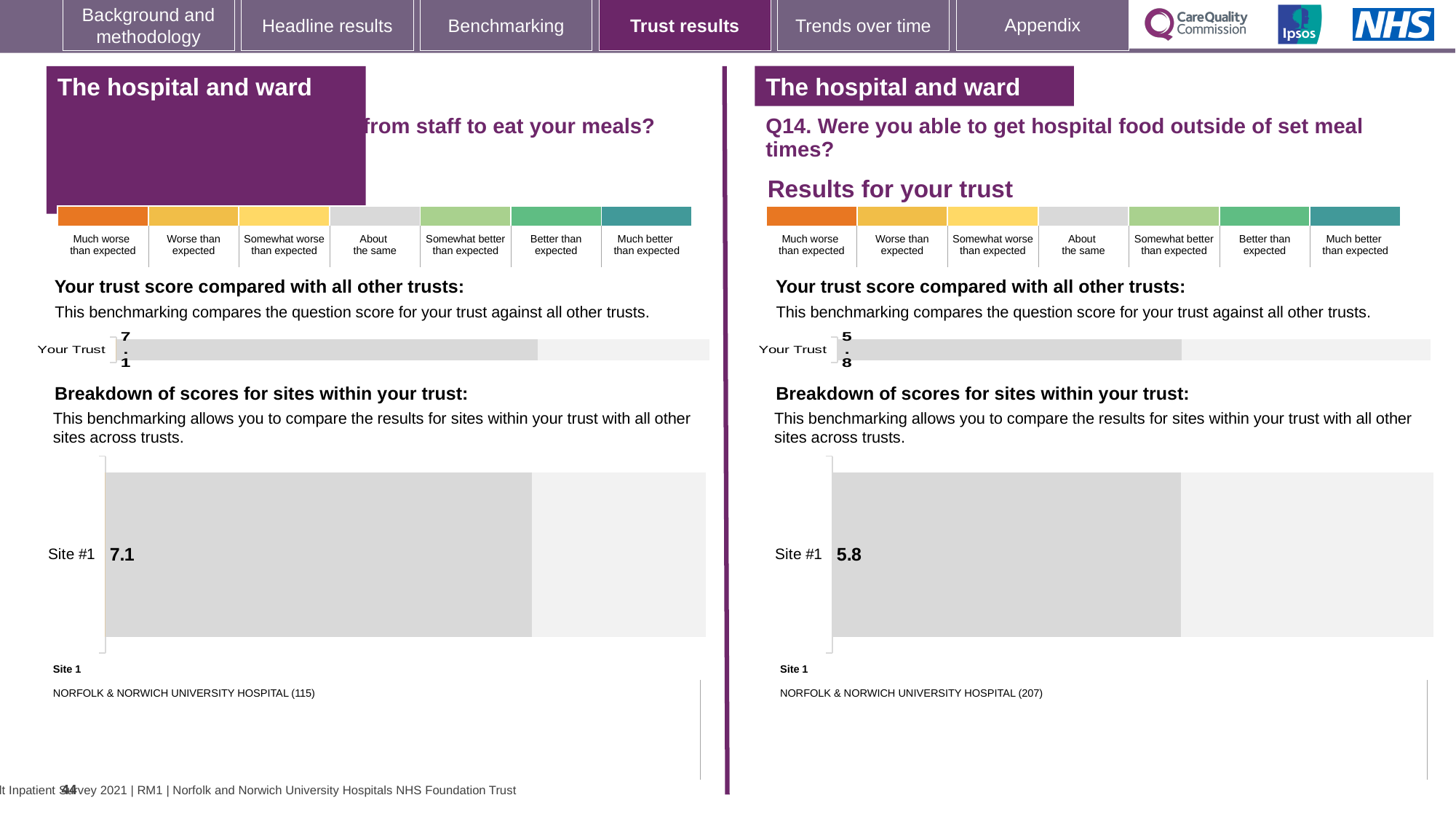
On the left half of the slide, in the 'Breakdown of scores for sites within your trust' chart, what is the value for Site #1? 7.1 On the left half of the slide, in the 'Your trust score compared with all other trusts' chart, what is the value for Your Trust? 7.1 Is the Site #1 value in the right-hand (Q14) site breakdown chart greater or less than 6? less What type of chart is used for the 'Breakdown of scores for sites within your trust' on the right half of the slide? Bar chart What is the label of the single bar in the 'Your trust score compared with all other trusts' chart on the left half of the slide? Your Trust What is the difference between the Site #1 value in the left-hand site breakdown chart (7.1) and the Site #1 value in the right-hand Q14 site breakdown chart (5.8)? 1.3 How many categories are plotted in the 'Your trust score compared with all other trusts' chart on the right half of the slide? 1 Which is larger: the Site #1 value in the left-hand site breakdown chart or the Site #1 value in the right-hand (Q14) site breakdown chart? The left-hand chart (7.1) On the right half of the slide (Q14), in the 'Your trust score compared with all other trusts' chart, what is the value for Your Trust? 5.8 Which site name is listed as Site 1 beneath the right-hand (Q14) site breakdown chart? NORFOLK & NORWICH UNIVERSITY HOSPITAL (207) On the right half of the slide (Q14), in the 'Breakdown of scores for sites within your trust' chart, what is the value for Site #1? 5.8 How many sites are plotted in the 'Breakdown of scores for sites within your trust' chart on the left half of the slide? 1